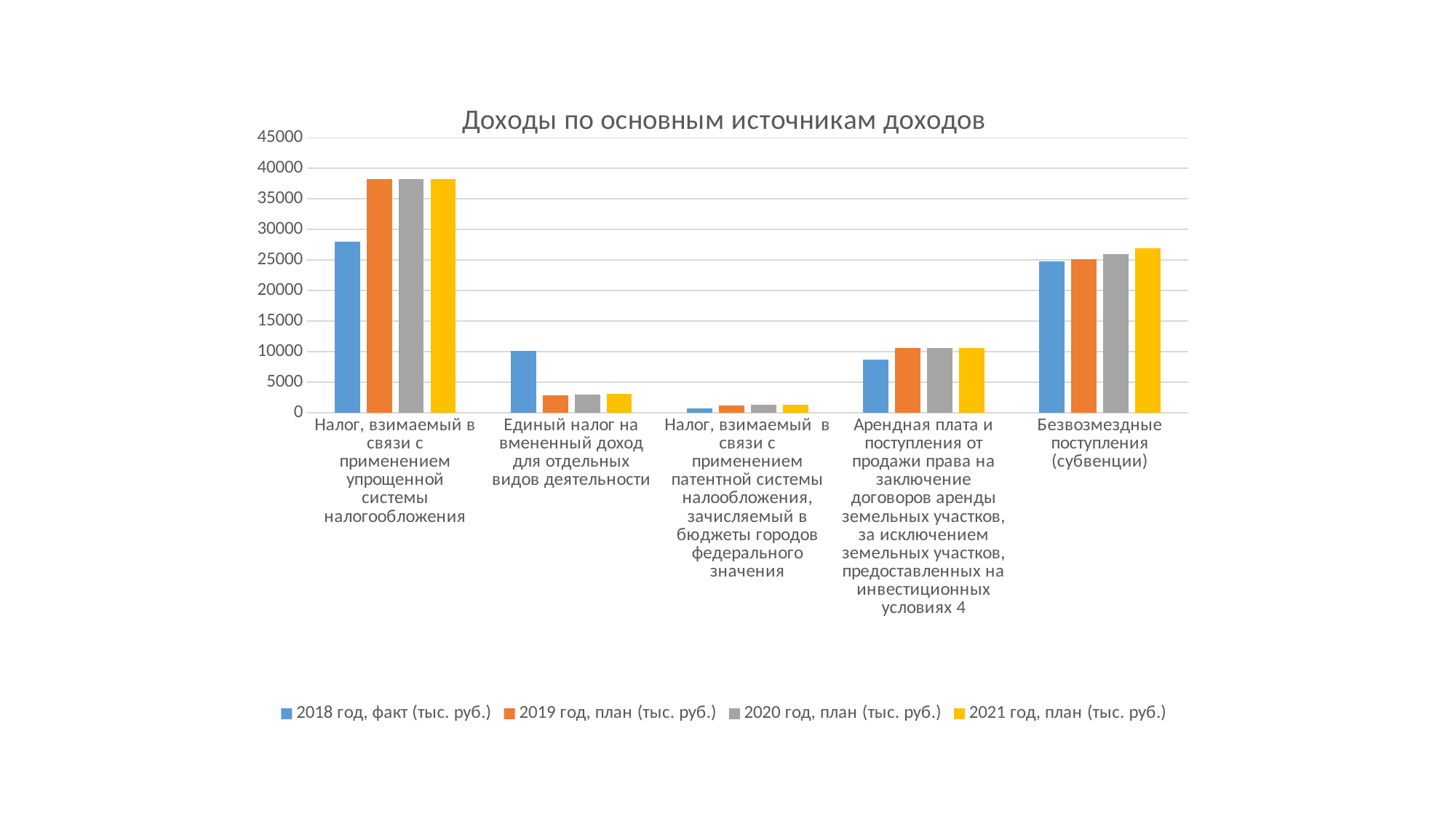
What kind of chart is shown on the slide? Bar chart Which category has the highest value for the series '2018 год, факт (тыс. руб.)'? Налог, взимаемый в связи с применением упрощенной системы налогообложения Is the 2019 год, план value for 'Единый налог на вмененный доход для отдельных видов деятельности' greater or less than 5000? less Is the 2018 год, факт value for 'Налог, взимаемый в связи с применением упрощенной системы налогообложения' greater or less than 25000? greater Which category has the lowest value for the series '2021 год, план (тыс. руб.)'? Налог, взимаемый в связи с применением патентной системы налообложения, зачисляемый в бюджеты городов федерального значения For 'Единый налог на вмененный доход для отдельных видов деятельности', which is larger: the 2018 год, факт value or the 2019 год, план value? 2018 год, факт How many categories are shown on the x axis of the chart? 5 For 'Безвозмездные поступления (субвенции)', do the values rise or fall from the 2018 series to the 2021 series? rise Is the 2021 год, план value for 'Безвозмездные поступления (субвенции)' greater or less than 25000? greater For the series '2021 год, план (тыс. руб.)', which is larger: 'Безвозмездные поступления (субвенции)' or 'Арендная плата и поступления от продажи права на заключение договоров аренды земельных участков...'? Безвозмездные поступления (субвенции) How many series does the legend list? 4 What is the title of the chart? Доходы по основным источникам доходов